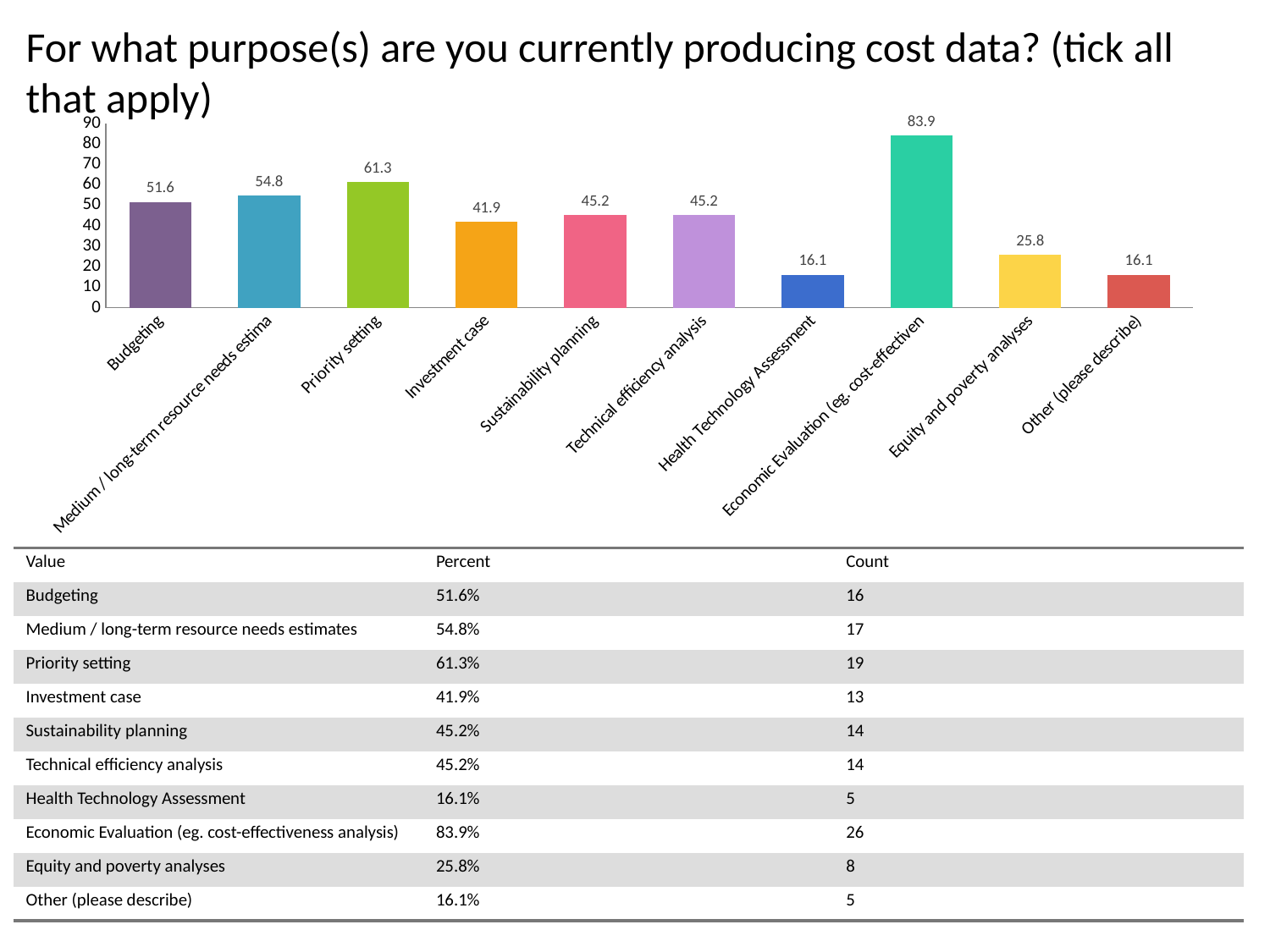
What value is shown for Economic Evaluation (eg. cost-effectiveness analysis)? 83.9 Which is larger, the value for Budgeting or the value for Medium / long-term resource needs estimates? Medium / long-term resource needs estimates What value is shown for Equity and poverty analyses? 25.8 What is the title of the chart? For what purpose(s) are you currently producing cost data? (tick all that apply) Which category has the highest value? Economic Evaluation (eg. cost-effectiveness analysis) Is the value for Priority setting greater or less than 50? greater What kind of chart is shown on the slide? bar chart How many categories are plotted in the chart? 10 What is the difference between the values for Economic Evaluation (eg. cost-effectiveness analysis) and Health Technology Assessment? 67.8 What value is shown for Budgeting? 51.6 Which two categories share the lowest value of 16.1? Health Technology Assessment and Other (please describe) What is the difference between the values for Priority setting and Investment case? 19.4